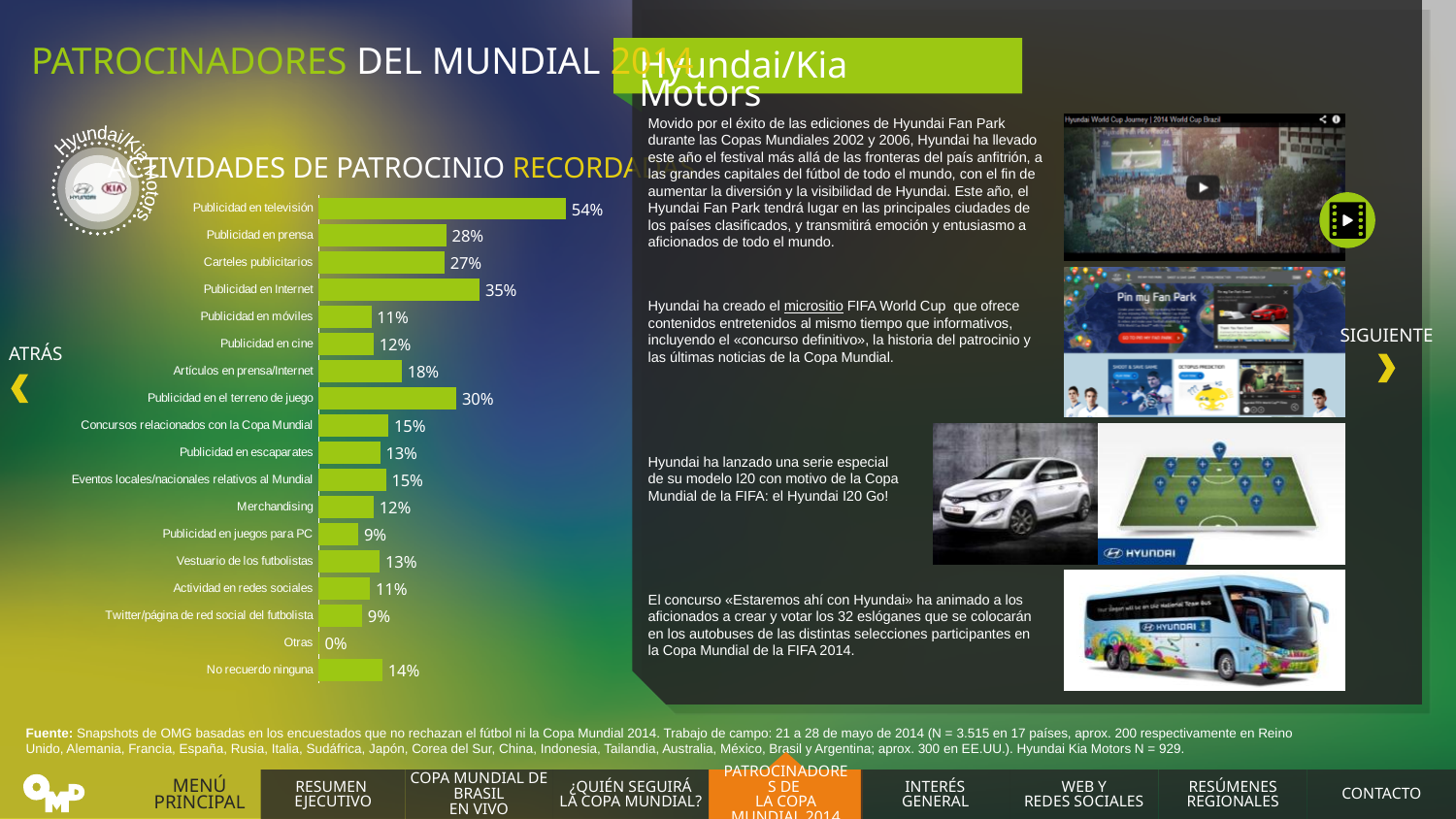
What is the value for No recuerdo ninguna? 14% Which category has the highest value? Publicidad en televisión How many categories does the bar chart show? 18 Which is larger, Publicidad en Internet or Publicidad en el terreno de juego? Publicidad en Internet What is the value for Artículos en prensa/Internet? 18% What is the difference between Publicidad en televisión and Publicidad en Internet? 19% What is the value for Publicidad en el terreno de juego? 30% Which category has the lowest value? Otras Which is larger, Merchandising or Vestuario de los futbolistas? Vestuario de los futbolistas What is the difference between Publicidad en prensa and Carteles publicitarios? 1% What kind of chart is shown on the slide? Bar chart What is the value for Publicidad en televisión? 54%